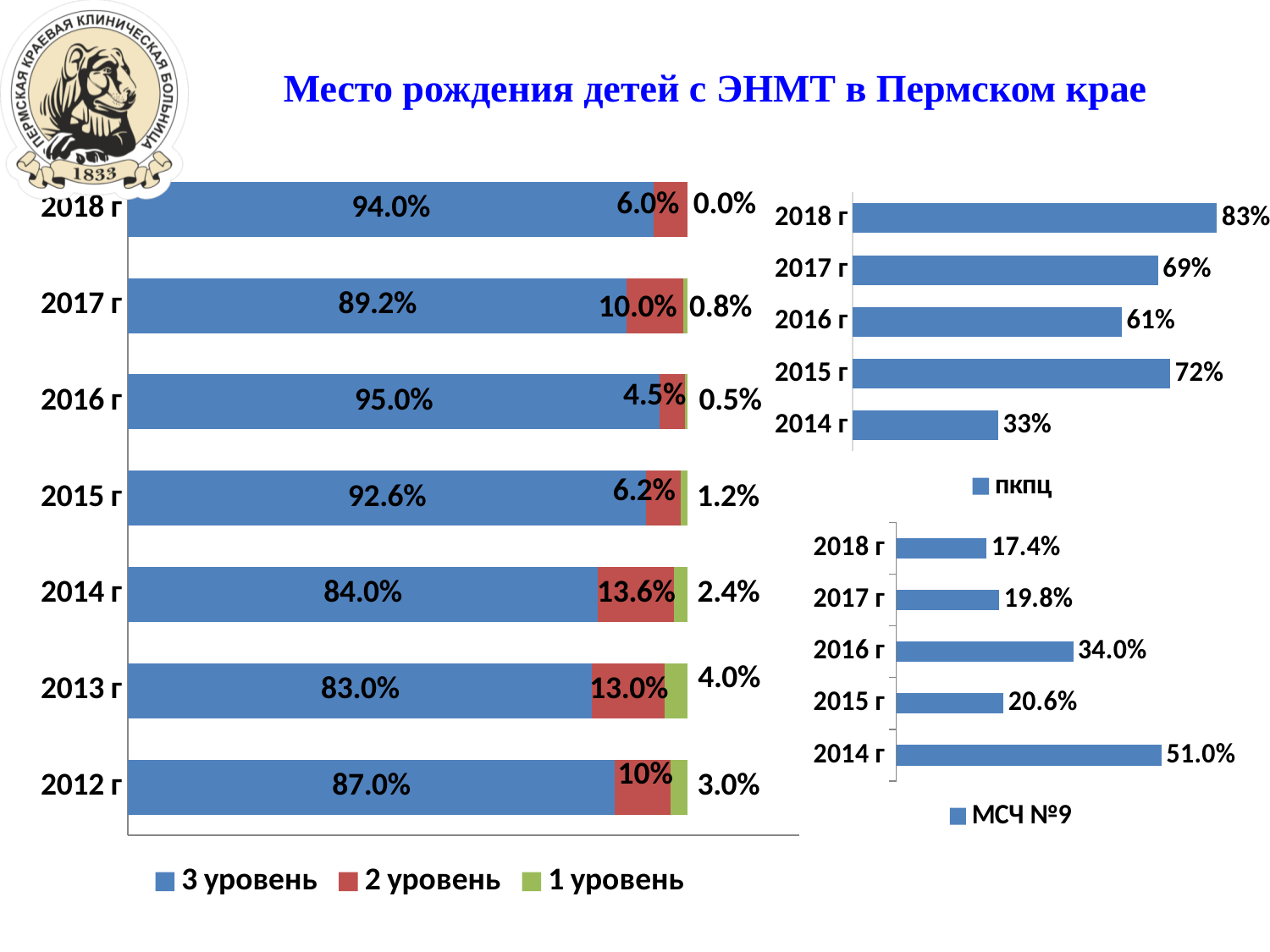
In the left stacked bar chart, what is the value of the 1 уровень series for 2013 г? 4.0% In the МСЧ №9 chart (bottom right), which is larger, the value for 2016 г or the value for 2015 г? 2016 г In the left stacked bar chart, which year has the highest value for the 3 уровень series? 2016 г In the left stacked bar chart, how many years are shown? 7 In the left stacked bar chart, which year has the lowest value for the 3 уровень series? 2013 г In the left stacked bar chart, what is the value of the 2 уровень series for 2014 г? 13.6% In the ПКПЦ chart (top right), what is the value for 2017 г? 69% In the МСЧ №9 chart (bottom right), which year has the highest value? 2014 г In the ПКПЦ chart (top right), which year has the lowest value? 2014 г In the ПКПЦ chart (top right), what is the difference between the values for 2018 г and 2014 г? 50% In the left stacked bar chart, what is the value of the 3 уровень series for 2018 г? 94.0% In the left stacked bar chart, how many series does the legend list? 3